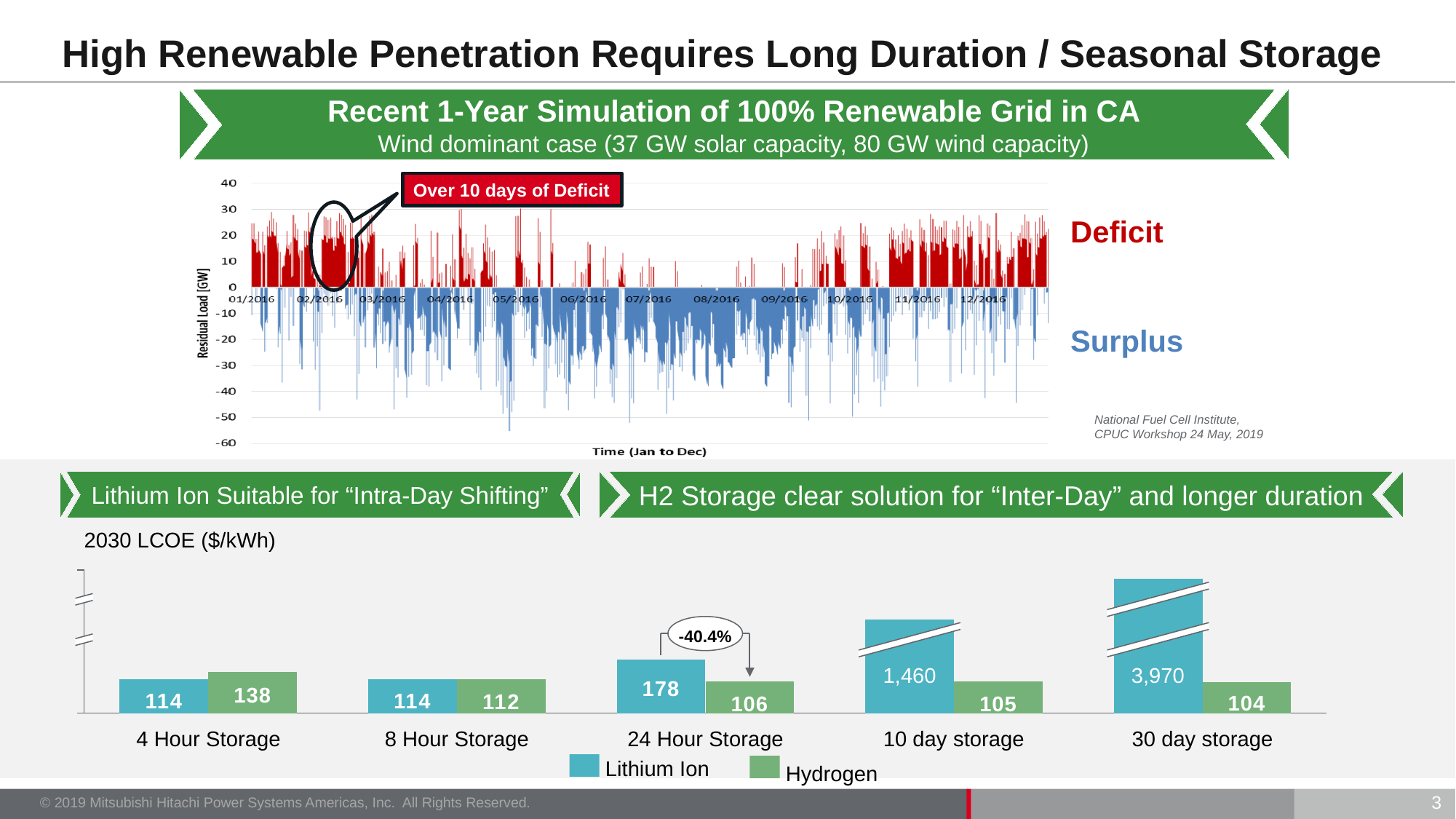
In the 2030 LCOE bar chart, how many storage duration categories are shown? 5 In the 2030 LCOE bar chart, do the Hydrogen values rise or fall as storage duration increases from 4 Hour Storage to 30 day storage? Fall In the 2030 LCOE bar chart, what is the Hydrogen value for 30 day storage? 104 In the 2030 LCOE bar chart, what is the Lithium Ion value for 10 day storage? 1,460 In the 2030 LCOE bar chart, for 4 Hour Storage, which is larger: Lithium Ion or Hydrogen? Hydrogen In the 2030 LCOE bar chart, what is the difference between the Lithium Ion and Hydrogen values for 24 Hour Storage? 72 In the 2030 LCOE bar chart, which storage duration has the highest Lithium Ion value? 30 day storage In the 2030 LCOE bar chart, which storage duration has the lowest Hydrogen value? 30 day storage In the 2030 LCOE bar chart, what is the Lithium Ion value for 24 Hour Storage? 178 In the 2030 LCOE bar chart, how many series does the legend list? 2 What kind of chart is the 2030 LCOE chart at the bottom of the slide? Bar chart In the top residual load chart, what is the label on the y axis? Residual Load [GW]